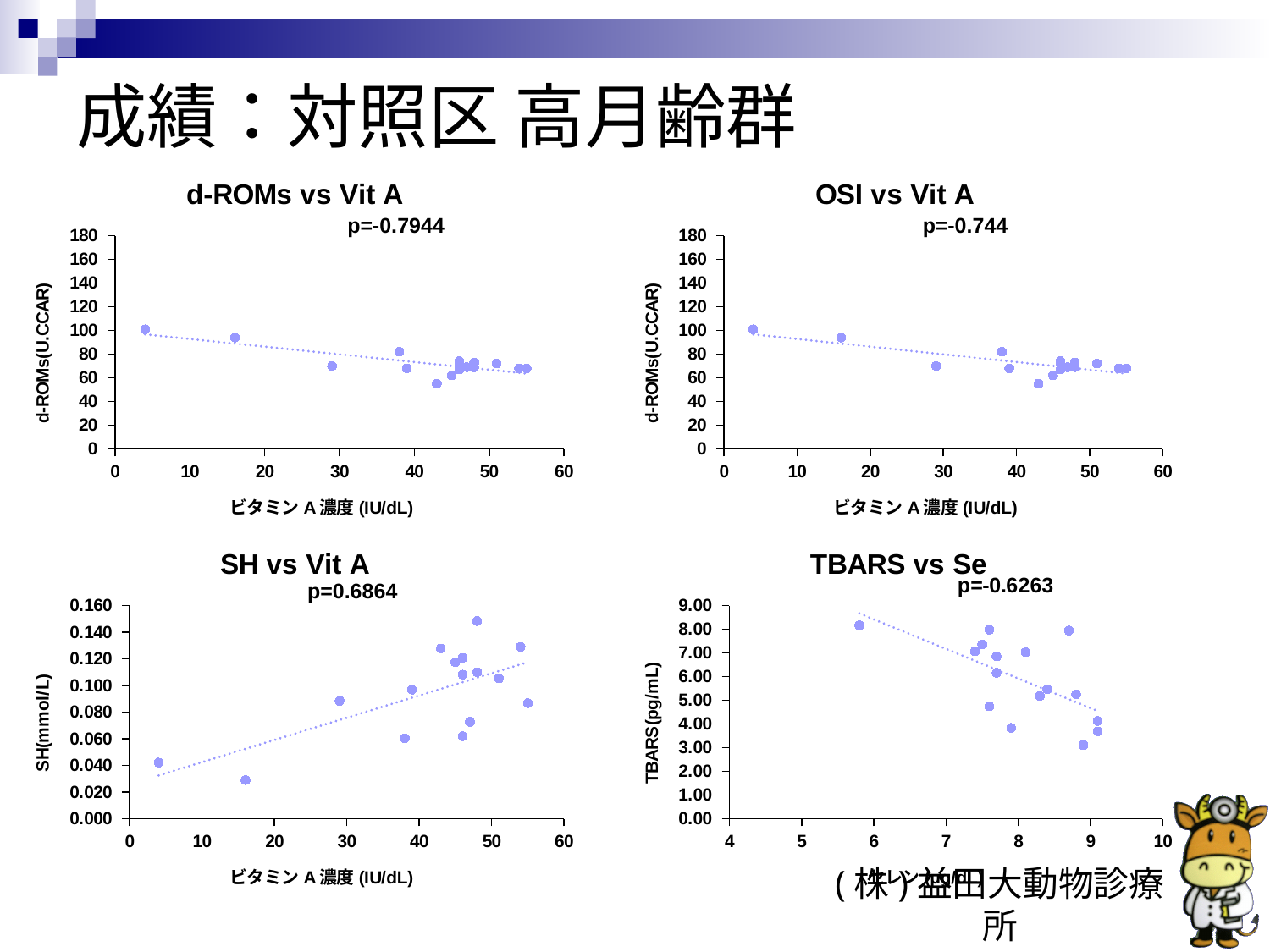
In the "TBARS vs Se" chart, is the TBARS value of the leftmost point (near x = 5.8) greater or less than 7.00? greater In the "d-ROMs vs Vit A" chart, do the d-ROMs values rise or fall as vitamin A concentration increases along the x axis? fall In the "SH vs Vit A" chart, is the highest point (near x = 48) greater or less than 0.140? greater In the "TBARS vs Se" chart, is the lowest point (near x = 9) greater or less than 4.00? less What is the y-axis label of the "TBARS vs Se" chart? TBARS(pg/mL) What kind of chart is the "d-ROMs vs Vit A" chart? scatter chart What p value is printed on the "d-ROMs vs Vit A" chart? p=-0.7944 In the "TBARS vs Se" chart, do the TBARS values rise or fall as the x-axis value increases? fall In the "SH vs Vit A" chart, do the SH values rise or fall as vitamin A concentration increases along the x axis? rise